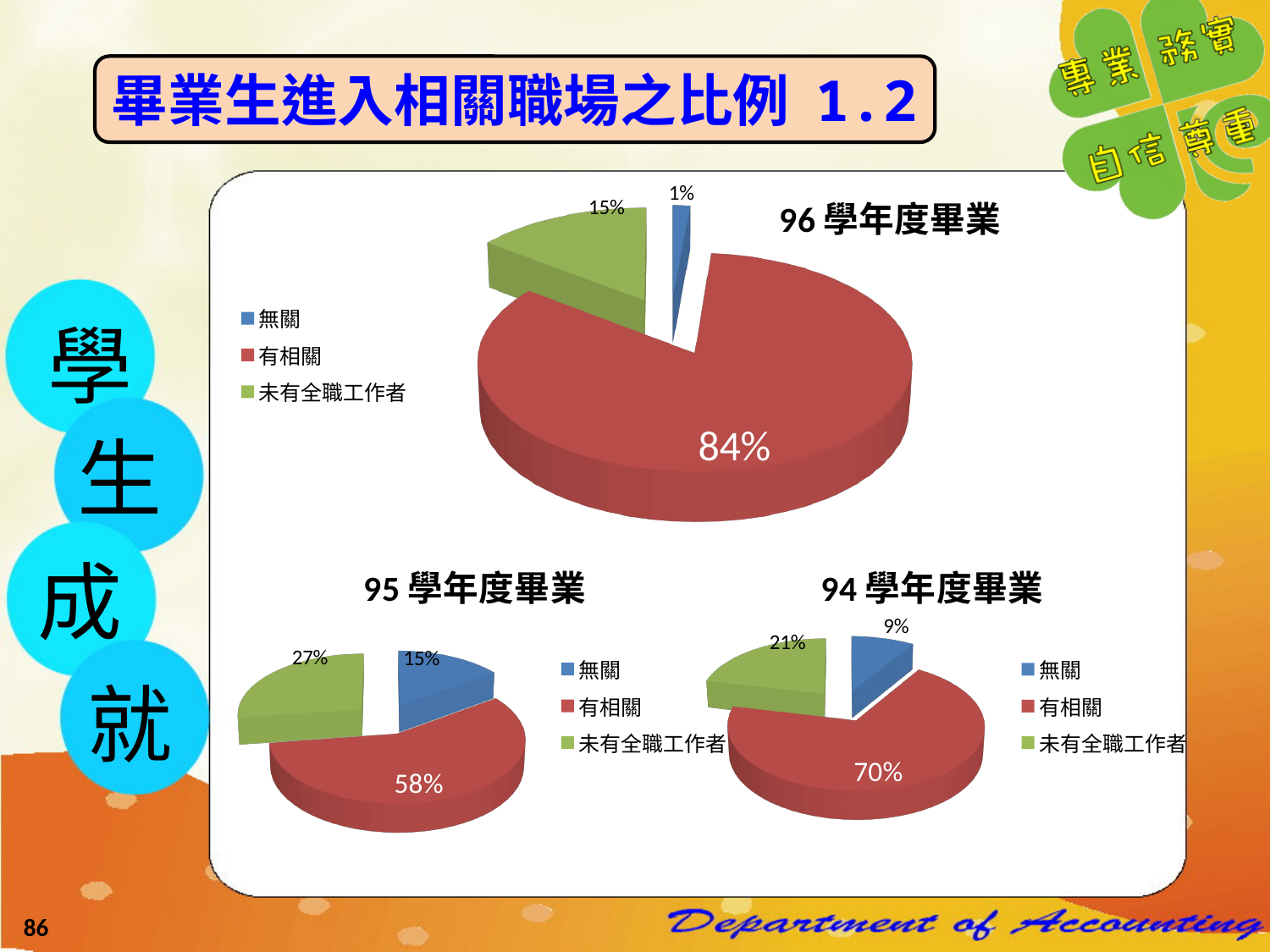
Which is larger: the 有相關 share in the 96 學年度畢業 chart or the 有相關 share in the 94 學年度畢業 chart? 96 學年度畢業 In the 95 學年度畢業 chart, what is the difference between the shares of 有相關 and 未有全職工作者? 31% What kind of chart is the 95 學年度畢業 chart? Pie chart In the 94 學年度畢業 chart, which category has the largest share? 有相關 How many pie charts are on the slide? 3 In the 95 學年度畢業 chart, which category has the smallest share? 無關 In the 96 學年度畢業 chart, what percentage is shown for 無關? 1% In the 96 學年度畢業 chart, what percentage is shown for 有相關? 84% In the 94 學年度畢業 chart, what colour is the 未有全職工作者 slice? Green In the 94 學年度畢業 chart, what percentage is shown for 無關? 9% How many categories does the 96 學年度畢業 chart show? 3 In the 95 學年度畢業 chart, what percentage is shown for 未有全職工作者? 27%